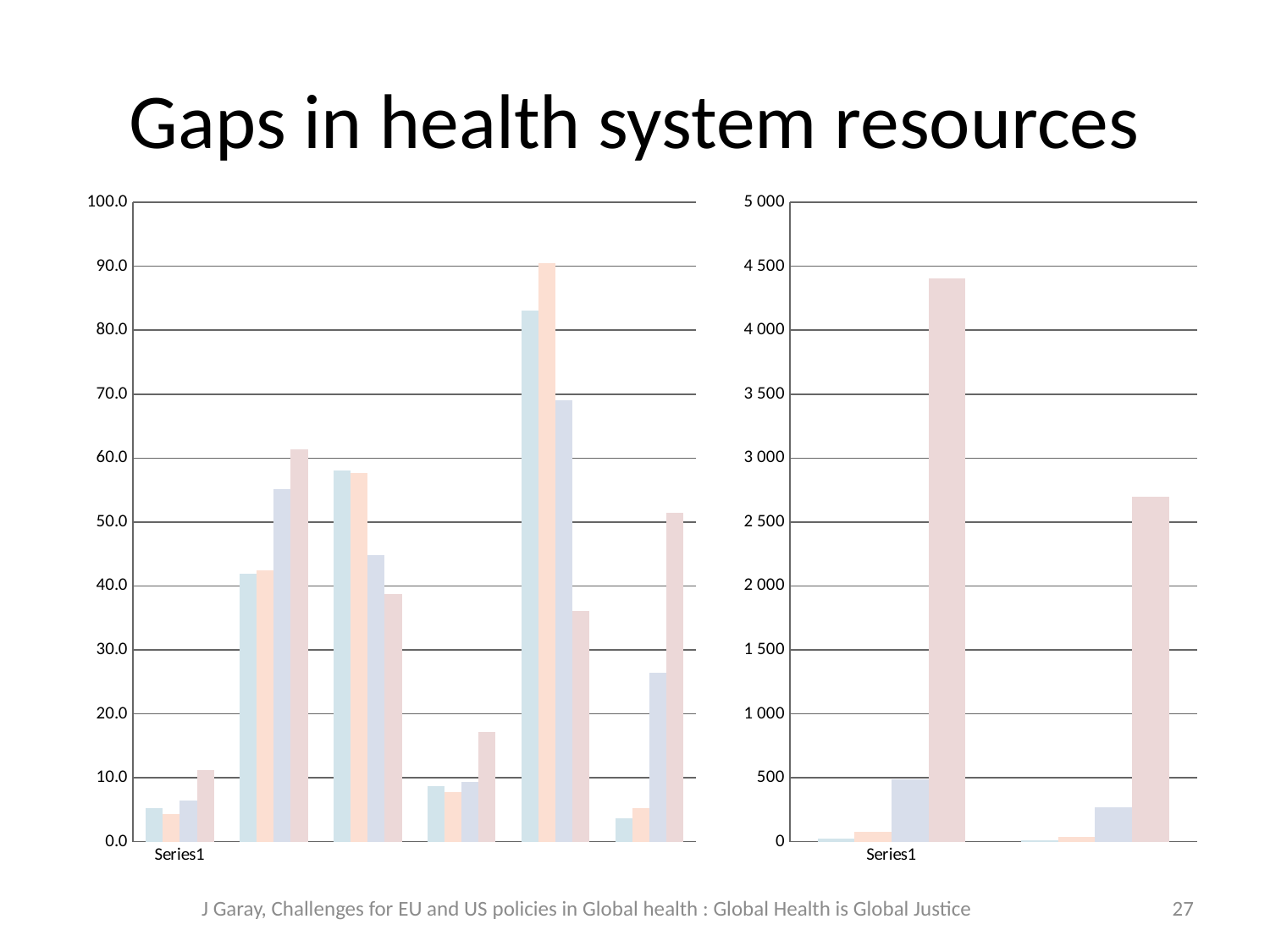
In the right chart, is the tallest bar in the Series1 group taller or shorter than the tallest bar in the other group? taller In the left chart, is the tallest bar in the Series1 group greater or less than 10? greater In the left chart, is the tallest bar on the whole chart greater or less than 80? greater What is the highest value shown on the vertical axis of the left chart? 100.0 What kind of chart is the chart on the right of the slide? bar chart In the right chart, is the tallest bar in the Series1 group greater or less than 4 000? greater How many bars are in each group of the left chart? 4 What is the highest value shown on the vertical axis of the right chart? 5 000 What kind of chart is the chart on the left of the slide? bar chart How many groups of bars does the right chart show? 2 How many groups of bars does the left chart show? 6